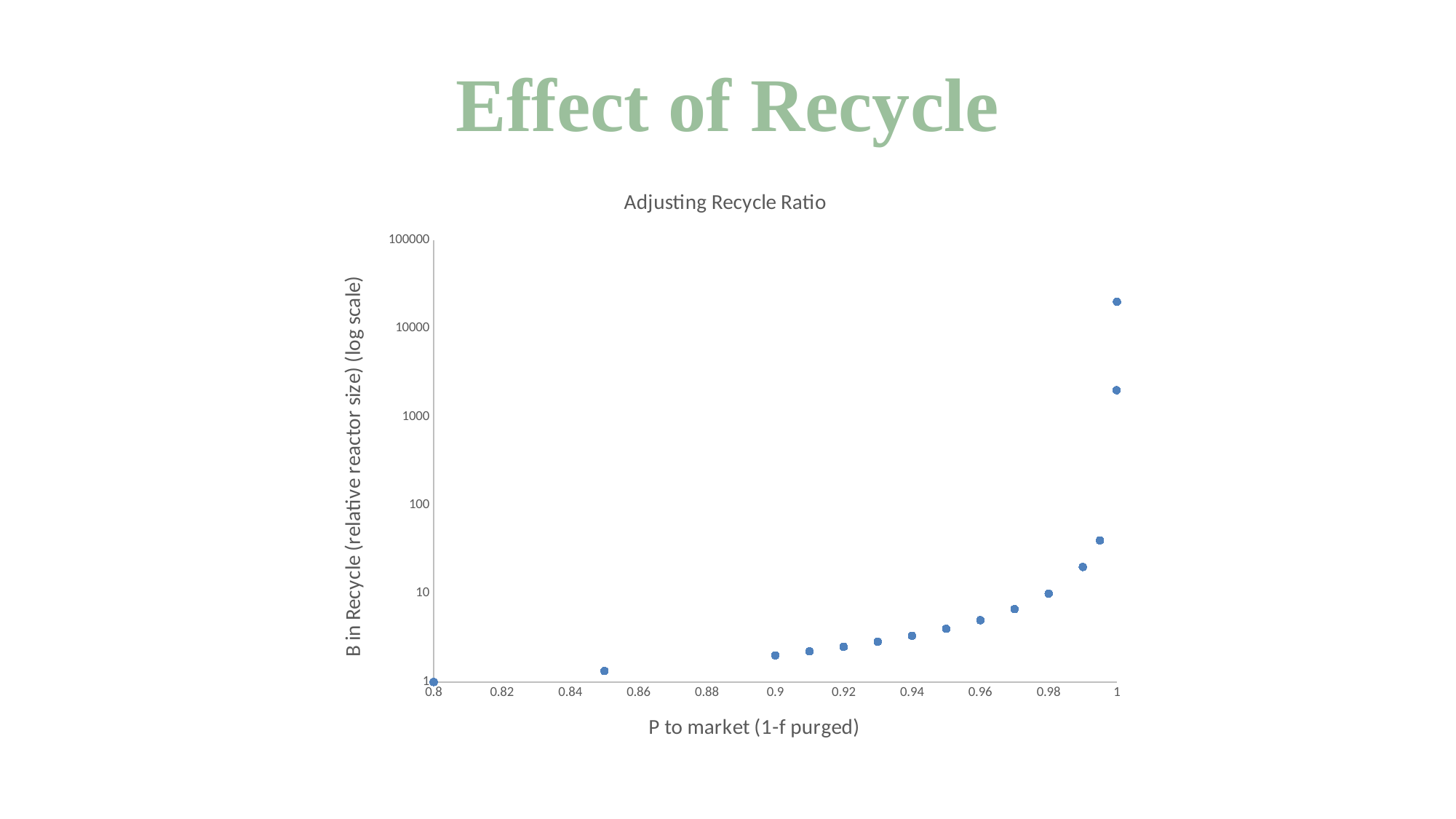
What is the x-axis title of the chart? P to market (1-f purged) What is the title of the chart? Adjusting Recycle Ratio Which has the larger value: the point at P to market = 0.95 or the point at P to market = 0.99? 0.99 Is the value for P to market = 0.9 greater or less than 10? less Is the highest plotted value greater or less than 10000? greater At which x-axis value does the lowest plotted point occur? 0.8 Do the plotted values rise or fall as P to market increases along the x axis? rise Is the value for P to market = 0.99 greater or less than 10? greater What kind of chart is shown on the slide? scatter chart At which x-axis value does the highest plotted point occur? 1